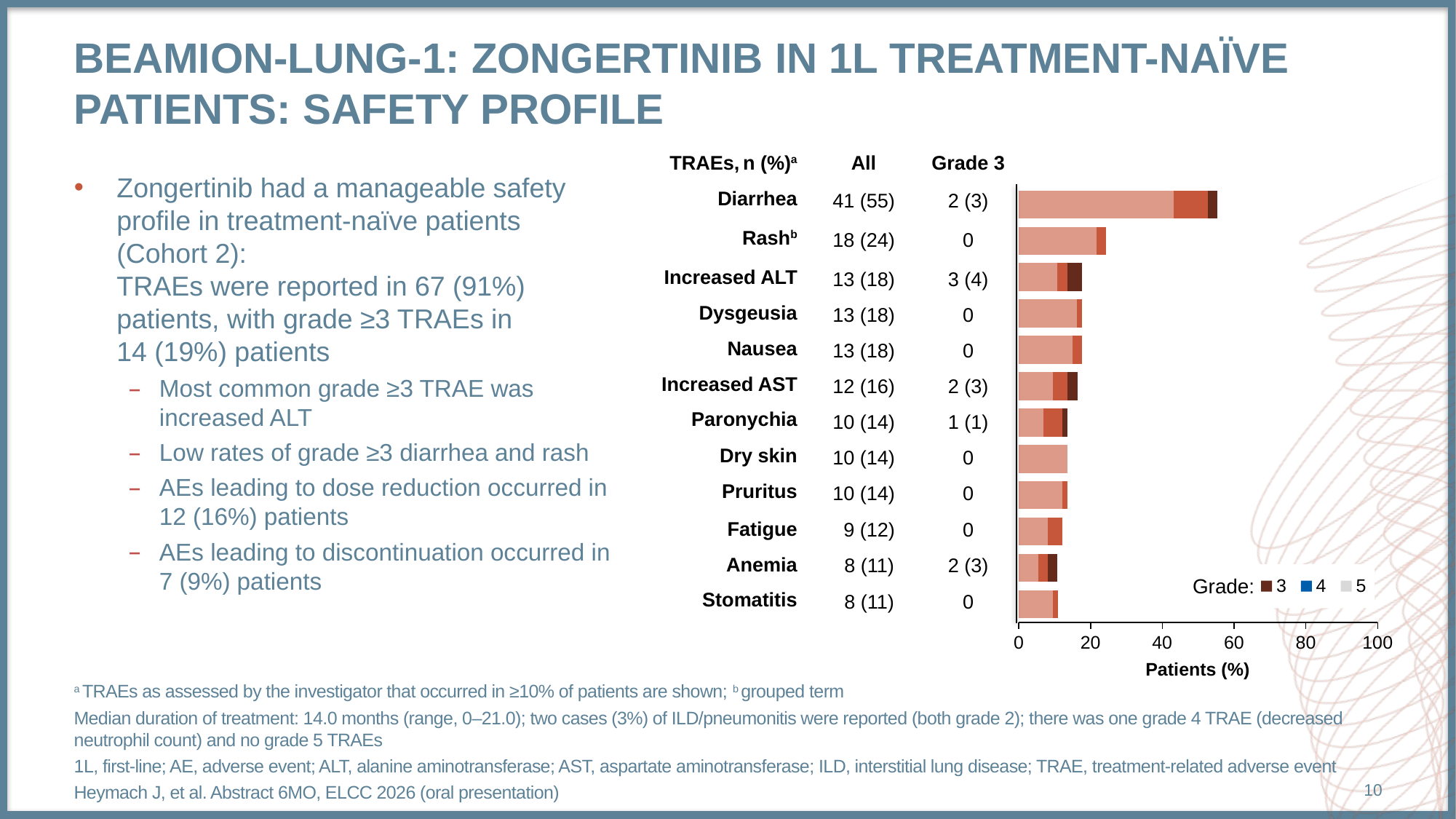
What is the title of the x axis of the chart? Patients (%) Which has a longer bar, Diarrhea or Rash? Diarrhea What kind of chart is shown on the slide? bar chart What is the 'All' value shown for Diarrhea? 41 (55) Which TRAE has the longest bar in the chart? Diarrhea How many TRAE categories are plotted in the chart? 12 How many grade series does the chart legend list? 3 Is the bar for Diarrhea greater or less than 40 on the Patients (%) axis? greater What is the difference in percentage points between the 'All' percentage for Diarrhea (55) and for Rash (24)? 31 What is the 'All' value shown for Paronychia? 10 (14) What is the 'Grade 3' value shown for Increased ALT? 3 (4) Is the bar for Stomatitis greater or less than 20 on the Patients (%) axis? less